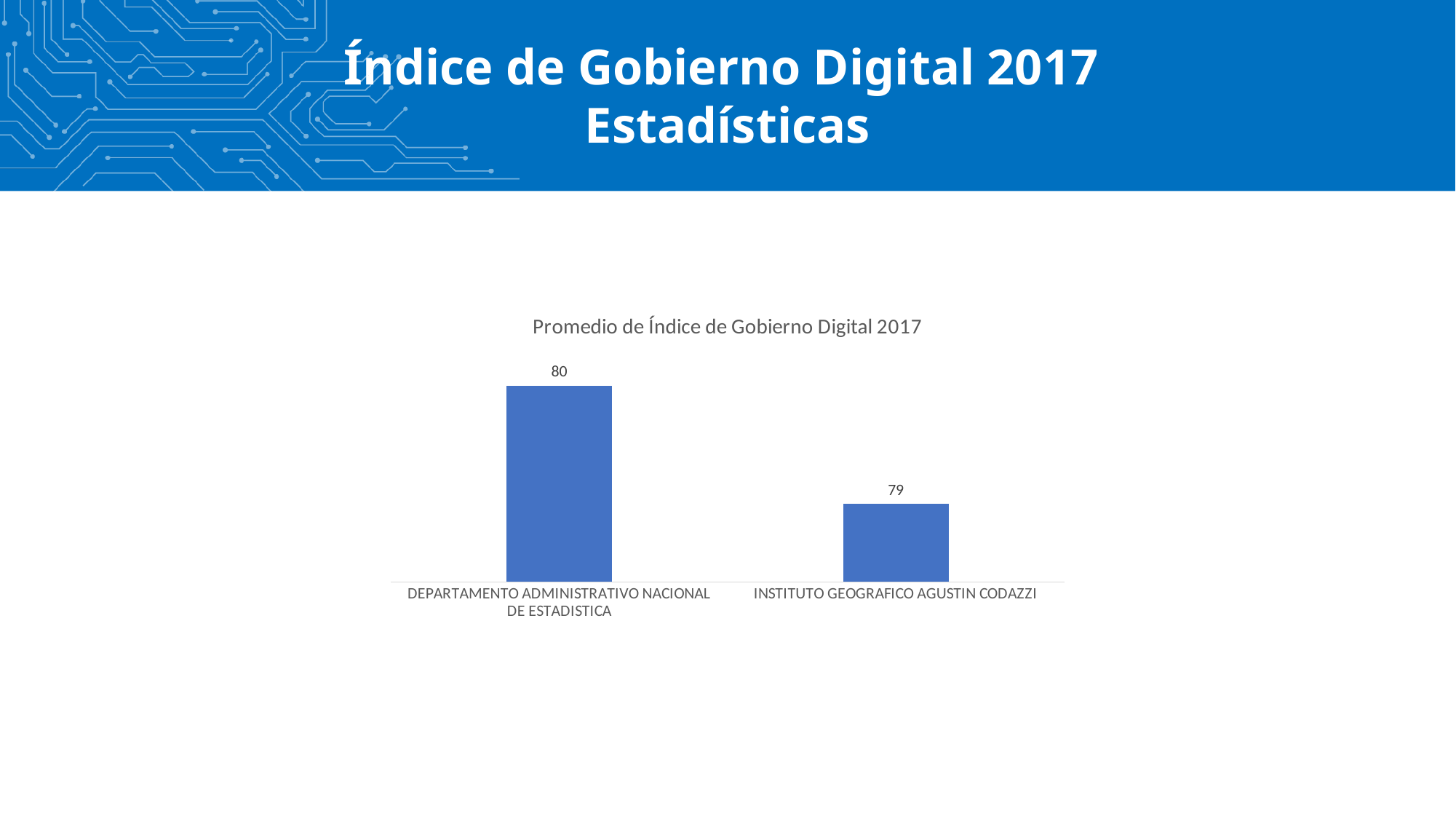
What is the difference between the values for DEPARTAMENTO ADMINISTRATIVO NACIONAL DE ESTADISTICA and INSTITUTO GEOGRAFICO AGUSTIN CODAZZI? 1 What is the title of the chart? Promedio de Índice de Gobierno Digital 2017 What is the value for INSTITUTO GEOGRAFICO AGUSTIN CODAZZI? 79 What kind of chart is shown on the slide? Bar chart Which category has the lowest value? INSTITUTO GEOGRAFICO AGUSTIN CODAZZI What colour are the bars in the chart? Blue Which category has the highest value? DEPARTAMENTO ADMINISTRATIVO NACIONAL DE ESTADISTICA What is the value for DEPARTAMENTO ADMINISTRATIVO NACIONAL DE ESTADISTICA? 80 Which has a larger value, DEPARTAMENTO ADMINISTRATIVO NACIONAL DE ESTADISTICA or INSTITUTO GEOGRAFICO AGUSTIN CODAZZI? DEPARTAMENTO ADMINISTRATIVO NACIONAL DE ESTADISTICA How many categories are shown in the chart? 2